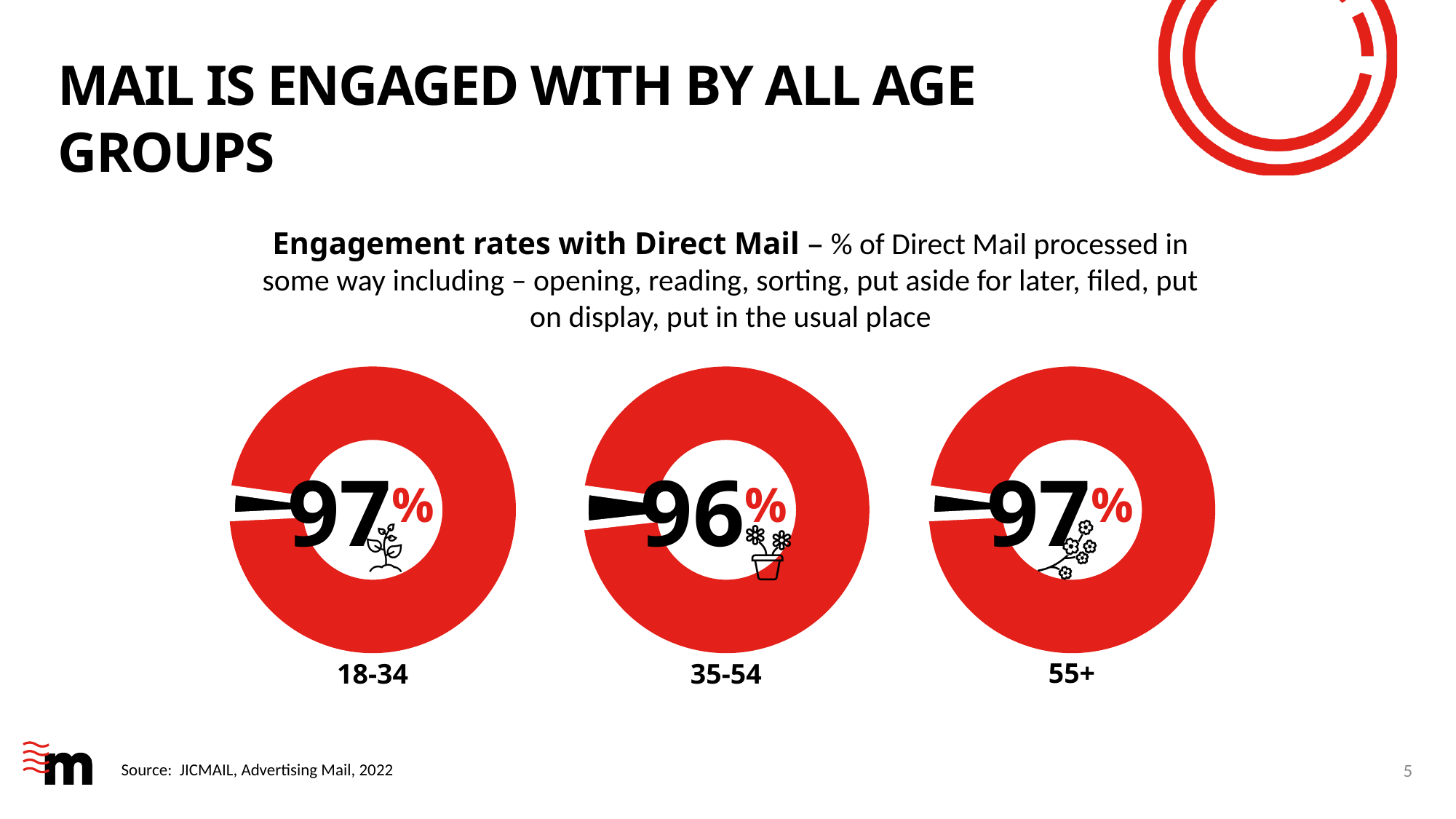
What is the difference in engagement rate between the 18-34 and 35-54 age groups? 1 percentage point How many age groups are shown on the slide? 3 What kind of chart is used to show each age group's engagement rate? Donut (pie) chart What is the source cited for the engagement rate data? JICMAIL, Advertising Mail, 2022 What colour are the donut charts on the slide? Red Is the engagement rate for the 35-54 age group greater or less than 90%? greater What is the engagement rate with Direct Mail for the 35-54 age group? 96% Which has a higher engagement rate, the 55+ age group or the 35-54 age group? 55+ Which age group has the lowest engagement rate with Direct Mail? 35-54 Do the 18-34 and 55+ age groups have the same engagement rate? Yes, both 97% What is the engagement rate with Direct Mail for the 55+ age group? 97% What is the engagement rate with Direct Mail for the 18-34 age group? 97%